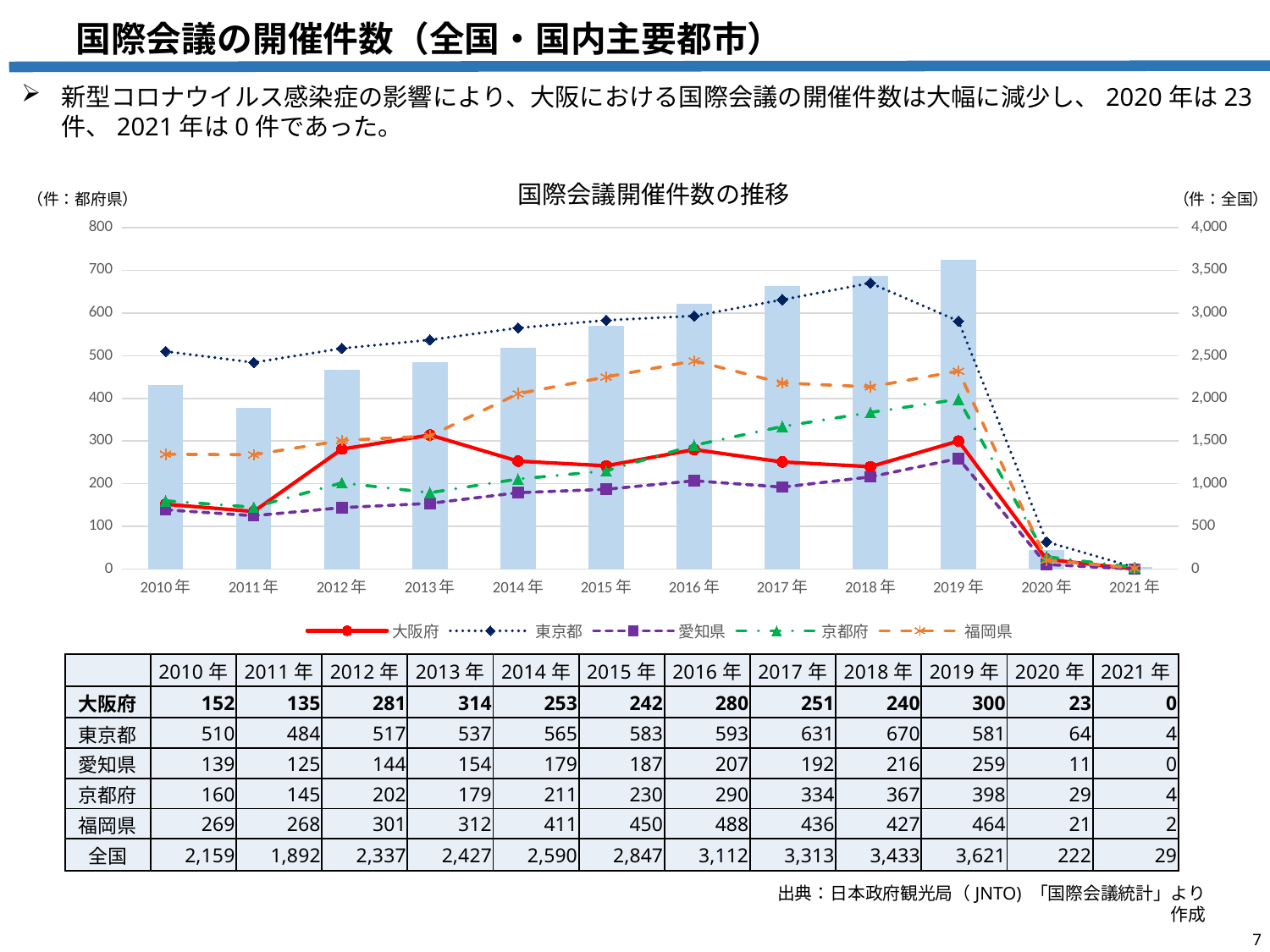
What is the title of the chart? 国際会議開催件数の推移 Which is larger in 2016年, the value for 京都府 or the value for 大阪府? 京都府 What is the value for 福岡県 in 2016年? 488 What is the value for 大阪府 in 2019年? 300 How many series does the chart legend list? 5 What is the difference between the 大阪府 values for 2019年 and 2020年? 277 In which year is the value for 大阪府 lowest? 2021年 What is the value for 全国 in 2019年? 3,621 How many years are shown on the x axis of the chart? 12 What is the value for 東京都 in 2018年? 670 Does the value for 全国 rise or fall from 2011年 to 2019年? rise In which year is the value for 東京都 highest? 2018年